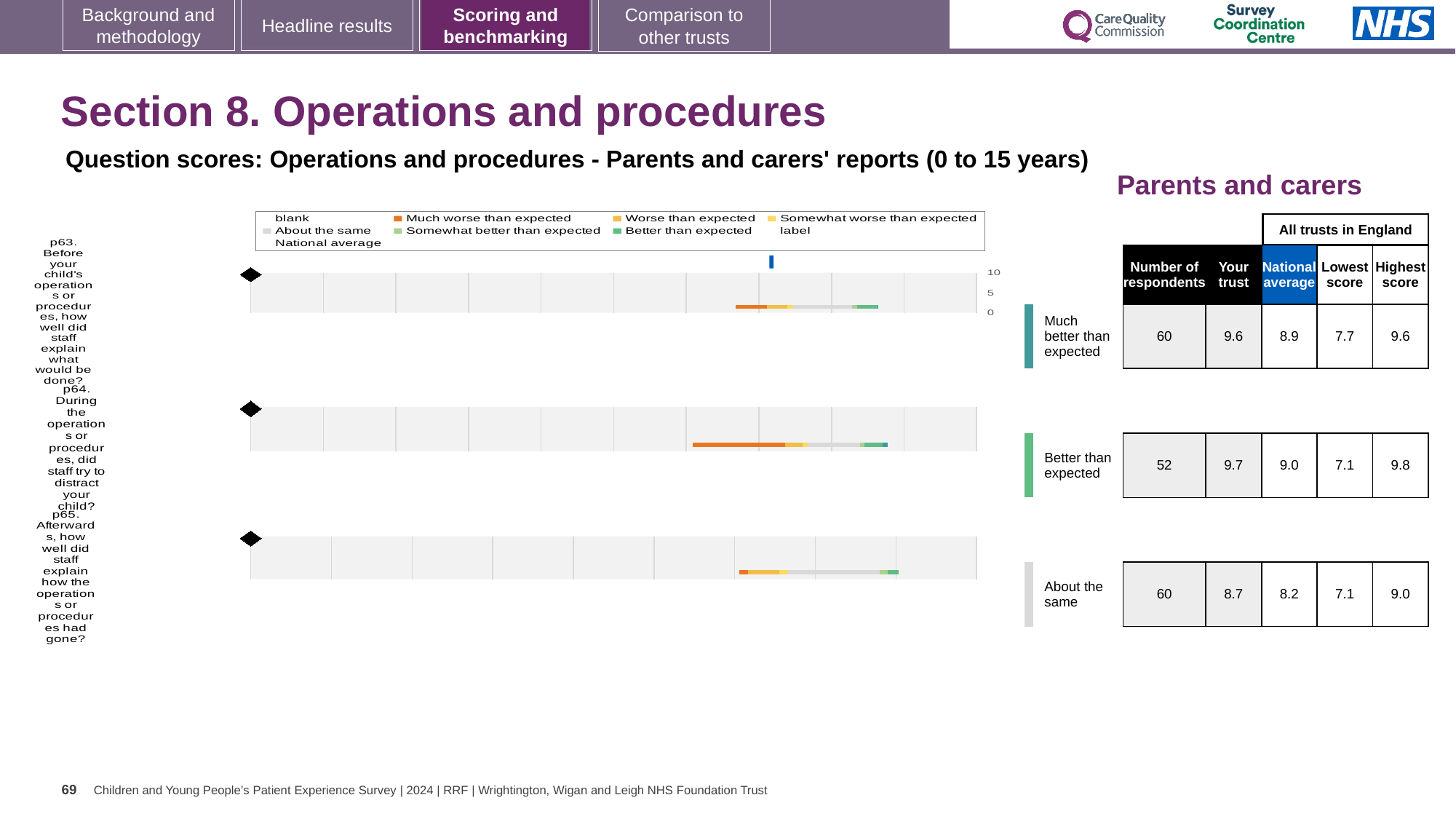
How many respondents answered question p65 (Afterwards, how well did staff explain how the operations or procedures had gone?)? 60 What benchmark category is shown for question p63? Much better than expected What is the 'Your trust' score for question p63 (Before your child's operations or procedures, how well did staff explain what would be done?)? 9.6 What kind of chart is used to show the question scores? Bar chart How many questions are plotted on the slide? 3 What is the highest score among all trusts in England for question p64? 9.8 What is the national average score for question p64 (During the operations or procedures, did staff try to distract your child?)? 9.0 What is the difference between the 'Your trust' score and the national average for question p65? 0.5 For question p63, which is larger: the 'Your trust' score or the national average? Your trust What benchmark category is shown for question p65? About the same Which question has the highest 'Your trust' score? p64 Which question has the lowest 'Your trust' score? p65